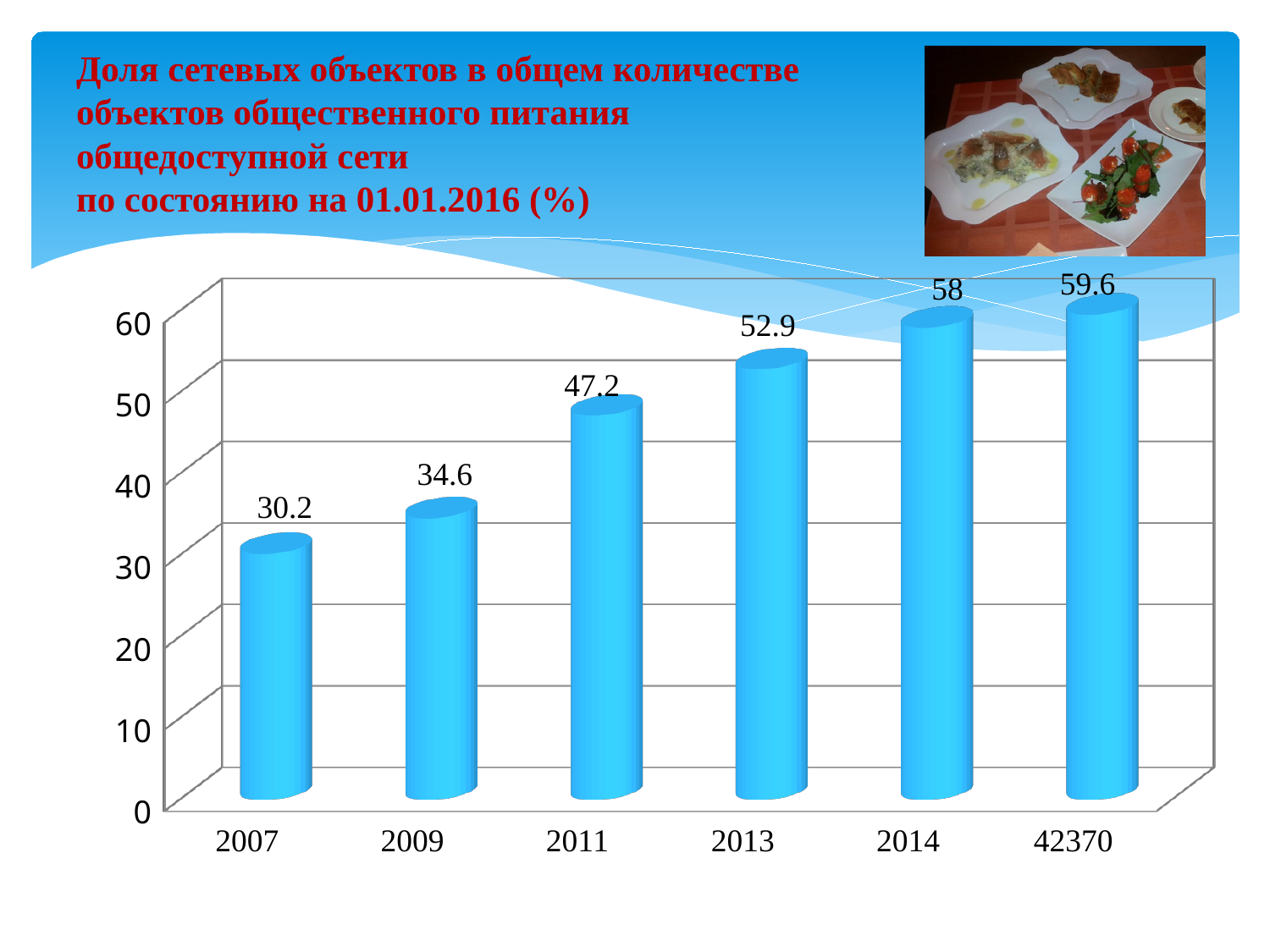
Which category has the highest value? 42370 What kind of chart is shown on the slide? bar chart Do the values rise or fall from left to right along the x axis? rise Which is larger, the value for 2011 or the value for 2013? 2013 What is the label of the last category on the x axis? 42370 What is the value for the category labelled 42370? 59.6 What is the value for 2011? 47.2 What is the value for 2014? 58 Which category has the lowest value? 2007 How many categories are shown on the x axis? 6 What is the difference between the values for 2013 and 2009? 18.3 What is the value for 2007? 30.2